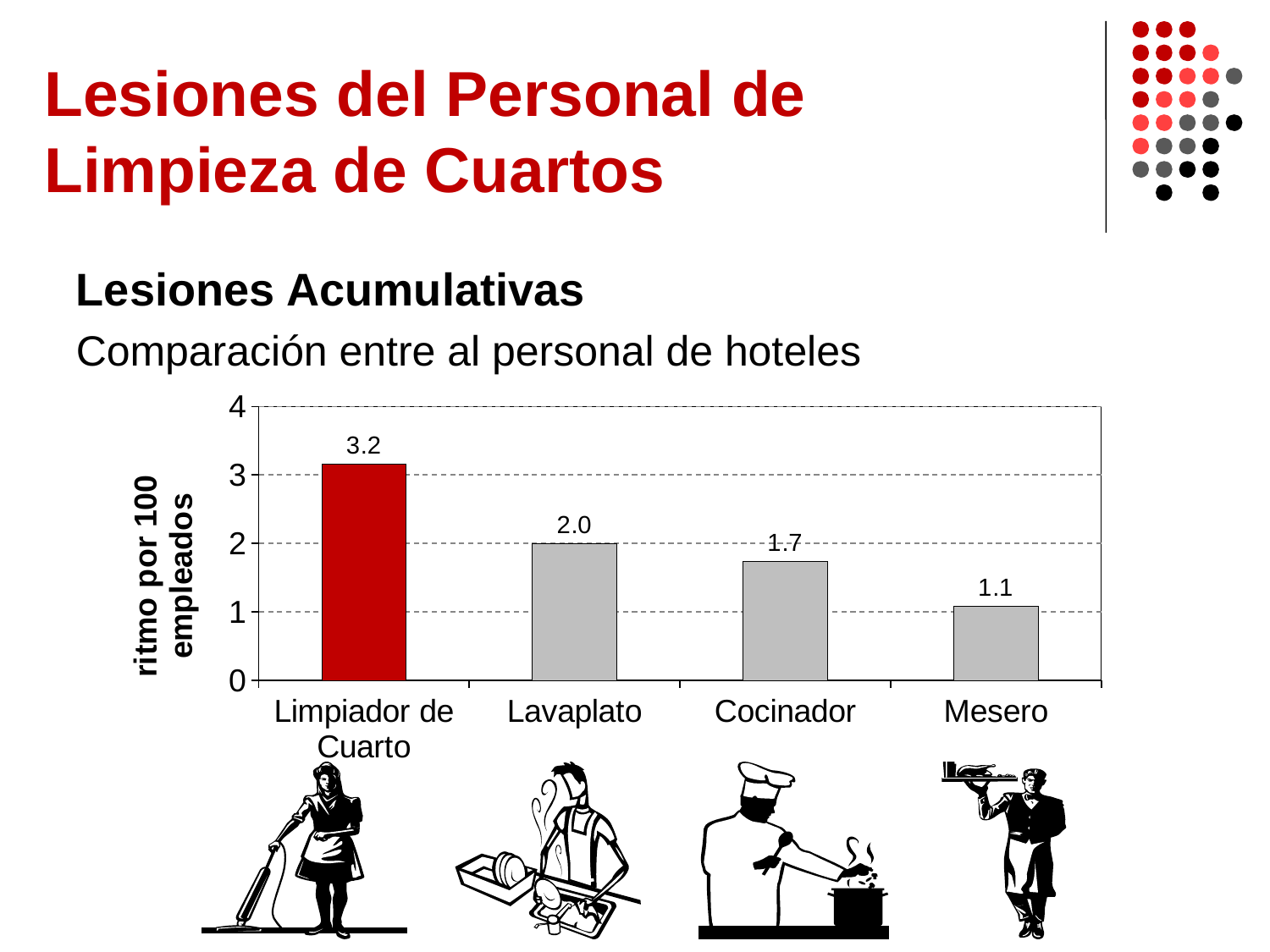
Which category has the lowest value? Mesero How many categories are shown on the x axis? 4 What is the value for Cocinador? 1.7 Which is larger, the value for Lavaplato or the value for Cocinador? Lavaplato What is the value for Mesero? 1.1 What is the value for Lavaplato? 2.0 What is the difference between the values for Lavaplato and Cocinador? 0.3 What kind of chart is shown? bar chart Which category has the highest value? Limpiador de Cuarto What is the label of the y axis? ritmo por 100 empleados What is the value for Limpiador de Cuarto? 3.2 What is the difference between the values for Limpiador de Cuarto and Mesero? 2.1